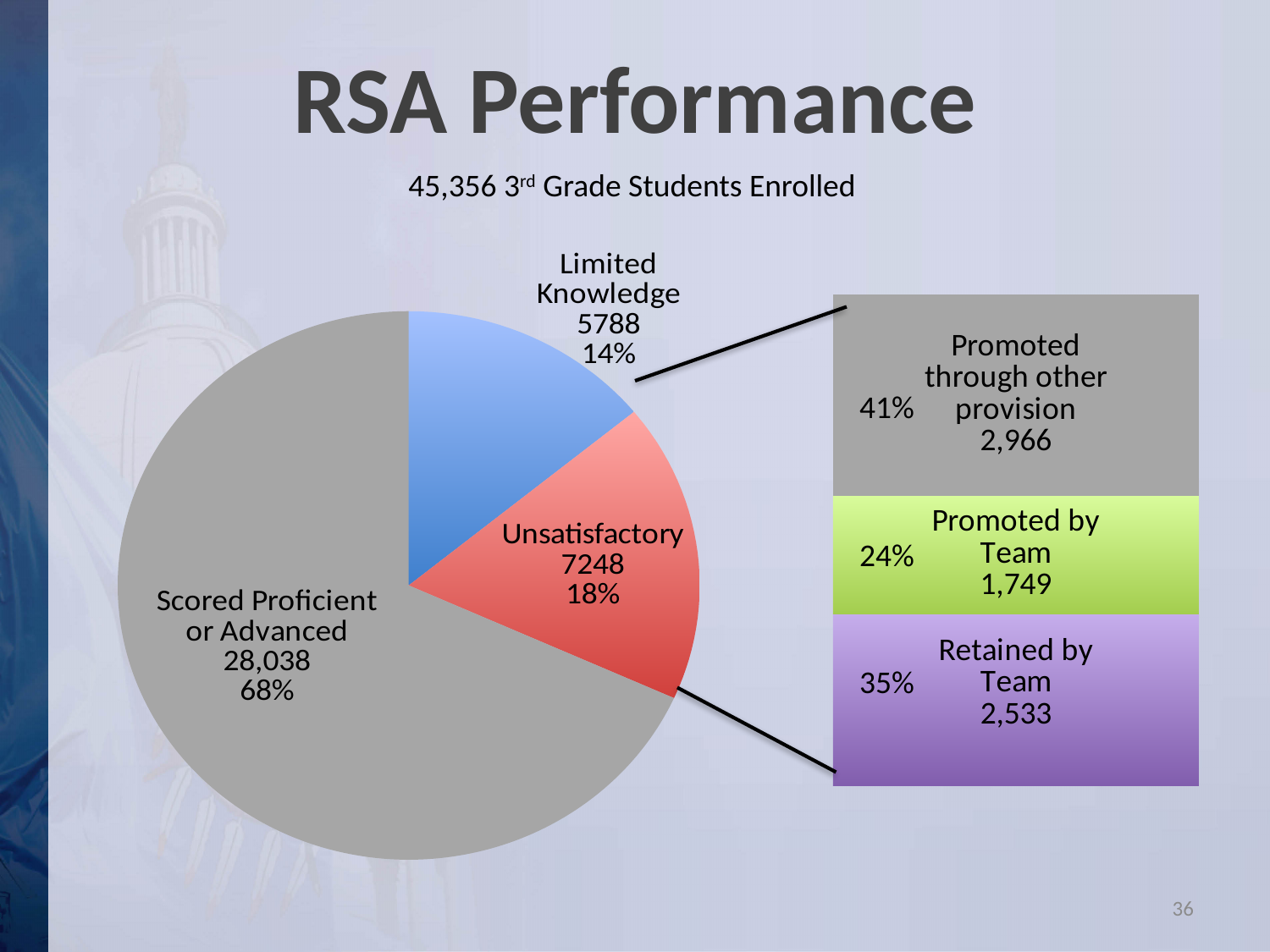
In the stacked bar on the right, which is larger: Retained by Team or Promoted by Team? Retained by Team In the pie chart, what percentage of students scored Unsatisfactory? 18% In the stacked bar on the right, what percentage were Retained by Team? 35% In the pie chart, how many more students scored Unsatisfactory than Limited Knowledge? 1460 What kind of chart is the main chart on the left of the slide? pie chart In the pie chart, how many students Scored Proficient or Advanced? 28,038 Which slice of the pie chart is the smallest? Limited Knowledge Which slice of the pie chart is the largest? Scored Proficient or Advanced In the stacked bar on the right, which segment has the largest value? Promoted through other provision How many slices does the pie chart have? 3 In the stacked bar on the right, how many students were Promoted by Team? 1,749 In the pie chart, how many students had Limited Knowledge? 5788